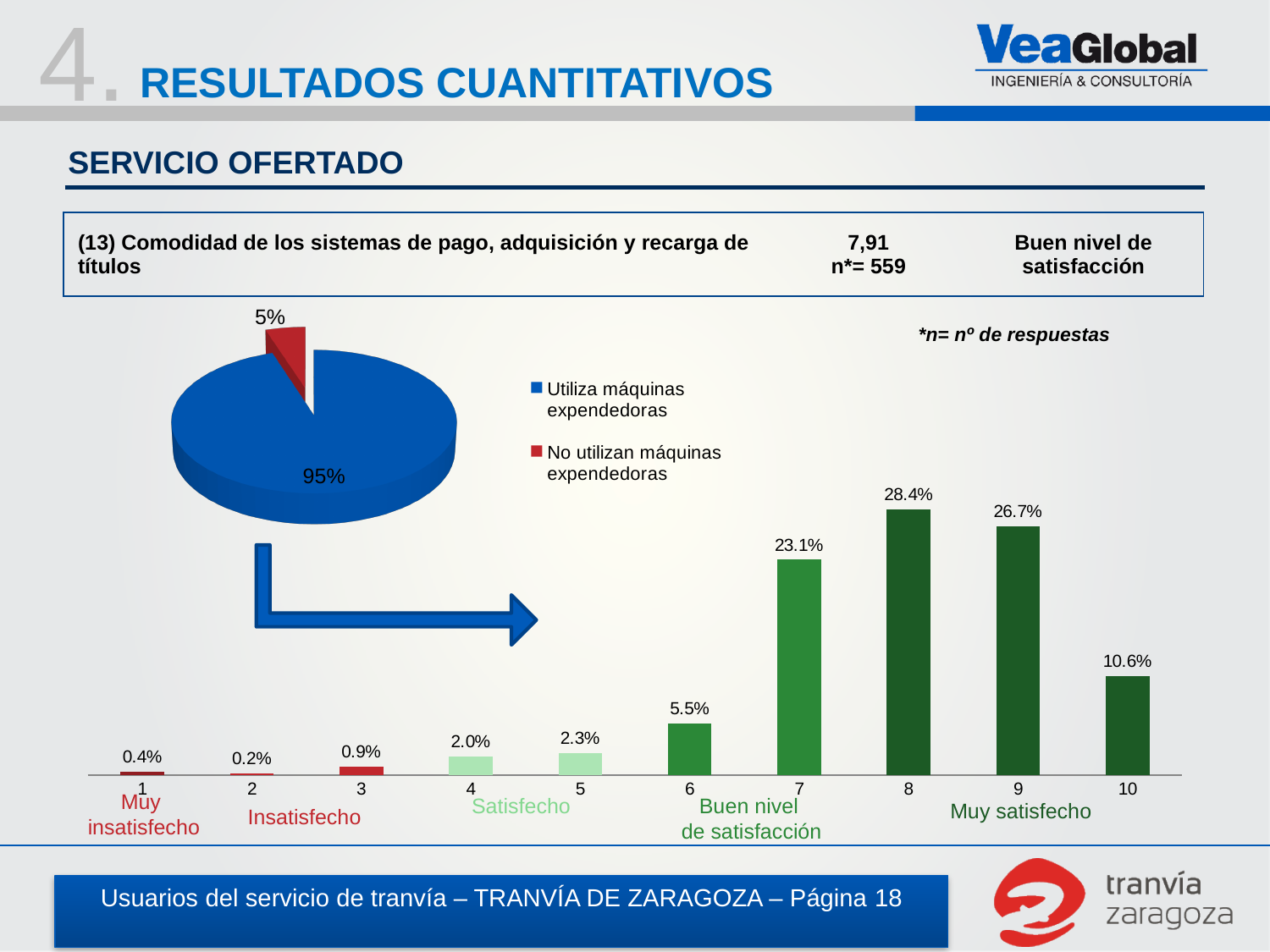
In the bar chart at the bottom, which rating has the lowest value? 2 How many rating categories are shown on the x axis of the bar chart at the bottom? 10 In the bar chart at the bottom, what is the value for rating 10? 10.6% In the bar chart at the bottom, which is larger, the value for rating 7 or the value for rating 10? Rating 7 How many entries does the legend of the pie chart list? 2 In the pie chart, what share of respondents do not use vending machines (No utilizan máquinas expendedoras)? 5% In the pie chart, what share of respondents use vending machines (Utiliza máquinas expendedoras)? 95% In the bar chart at the bottom, what is the difference between the values for rating 8 and rating 9? 1.7% In the bar chart at the bottom, which rating has the highest value? 8 What kind of chart is the chart at the top left of the slide? Pie chart In the bar chart at the bottom, what is the value for rating 8? 28.4% What kind of chart is the chart at the bottom of the slide showing ratings 1 to 10? Bar chart